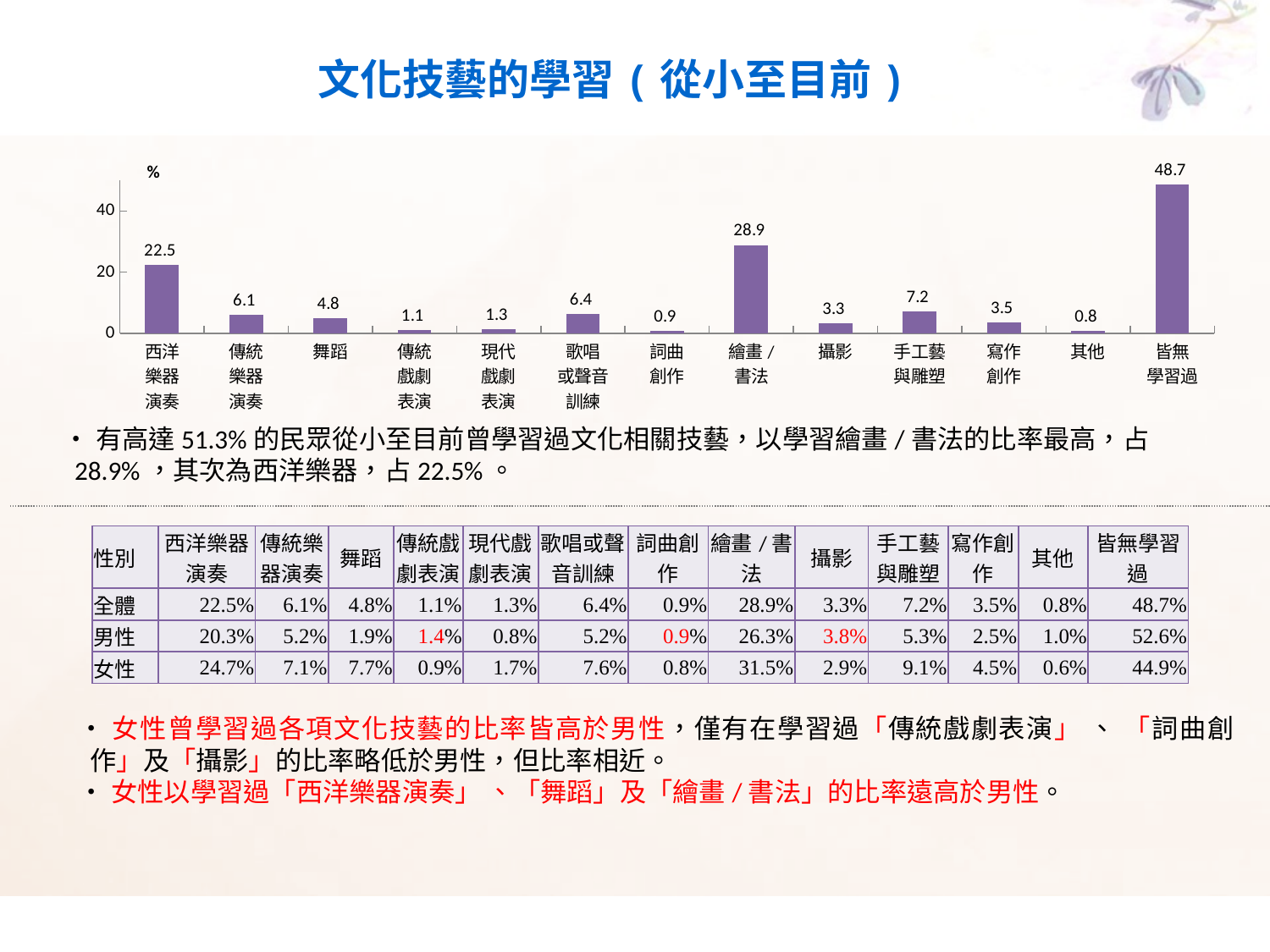
What unit is indicated on the vertical axis of the chart? % Which category has the lowest value in the chart? 其他 What kind of chart is shown on the slide? bar chart What is the value for 繪畫／書法 in the chart? 28.9 What is the value for 西洋樂器演奏 in the chart? 22.5 What is the difference between the values for 皆無學習過 and 繪畫／書法? 19.8 What is the value for 手工藝與雕塑 in the chart? 7.2 Which is larger, the value for 手工藝與雕塑 or the value for 歌唱或聲音訓練? 手工藝與雕塑 Which category has the highest value in the chart? 皆無學習過 How many categories are shown in the chart? 13 Is the value for 繪畫／書法 greater or less than 20? greater What is the difference between the values for 西洋樂器演奏 and 傳統樂器演奏? 16.4